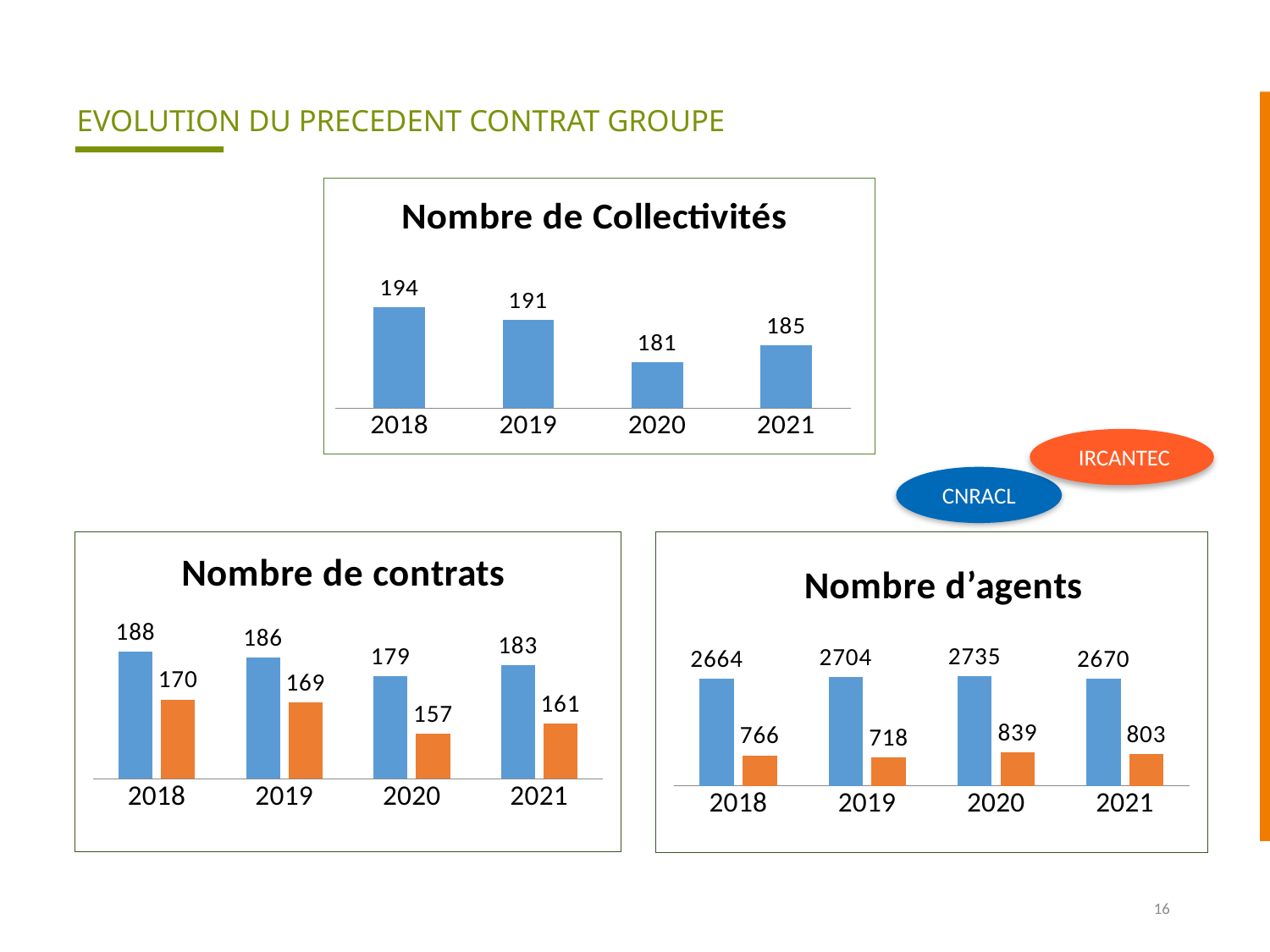
In the 'Nombre de Collectivités' chart, how many years are shown on the x axis? 4 In the 'Nombre d’agents' chart, what is the value of the blue (CNRACL) bar for 2019? 2704 In the 'Nombre d’agents' chart, is the orange (IRCANTEC) value for 2020 larger or smaller than the orange value for 2019? larger In the 'Nombre de contrats' chart, what is the value of the orange (IRCANTEC) bar for 2021? 161 In the 'Nombre de Collectivités' chart, which year has the lowest value? 2020 In the 'Nombre d’agents' chart, which year has the highest blue (CNRACL) value? 2020 In the 'Nombre de contrats' chart, what is the difference between the blue and orange bars for 2018? 18 What type of chart is the 'Nombre d’agents' chart? bar chart In the 'Nombre de contrats' chart, what is the value of the blue (CNRACL) bar for 2020? 179 In the 'Nombre de Collectivités' chart, what is the value for 2018? 194 In the 'Nombre de Collectivités' chart, what is the difference between the 2018 and 2021 values? 9 In the 'Nombre de contrats' chart, which year has the lowest orange (IRCANTEC) value? 2020